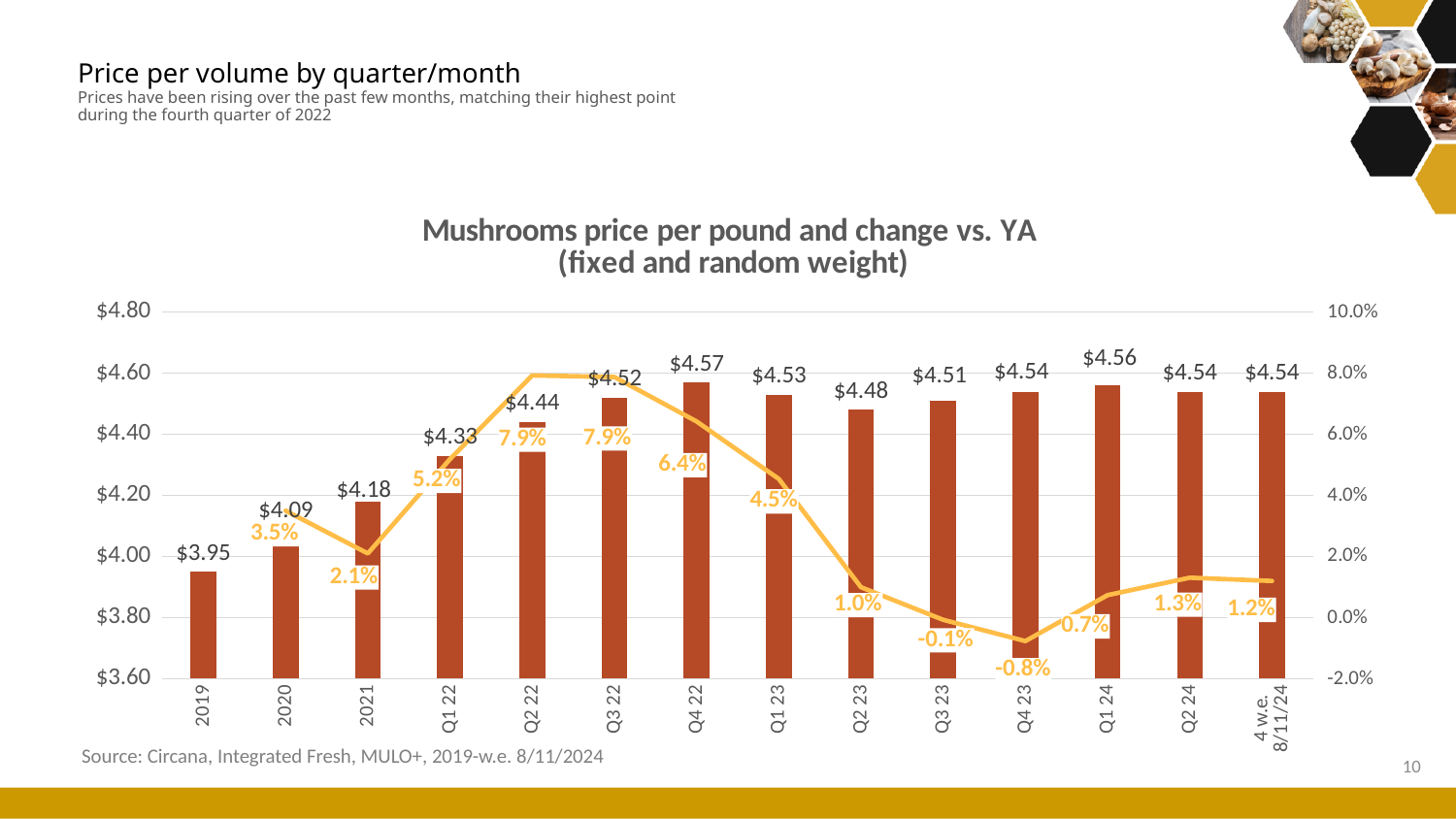
What is the title of the chart? Mushrooms price per pound and change vs. YA (fixed and random weight) How many periods are shown on the x axis? 14 What is the change vs. YA shown for Q2 23? 1.0% Which period has the highest price per pound? Q4 22 Which has the higher price per pound, Q1 24 or Q2 24? Q1 24 Do the price per pound bars rise or fall from 2019 to Q4 22? Rise Which period has the lowest price per pound? 2019 What is the mushrooms price per pound for Q4 22? $4.57 Which period has the lowest change vs. YA on the line? Q4 23 What is the difference between the price per pound in Q4 22 and in 2019? $0.62 What kind of chart is this? Combination bar and line chart What is the change vs. YA shown for Q3 23? -0.1%